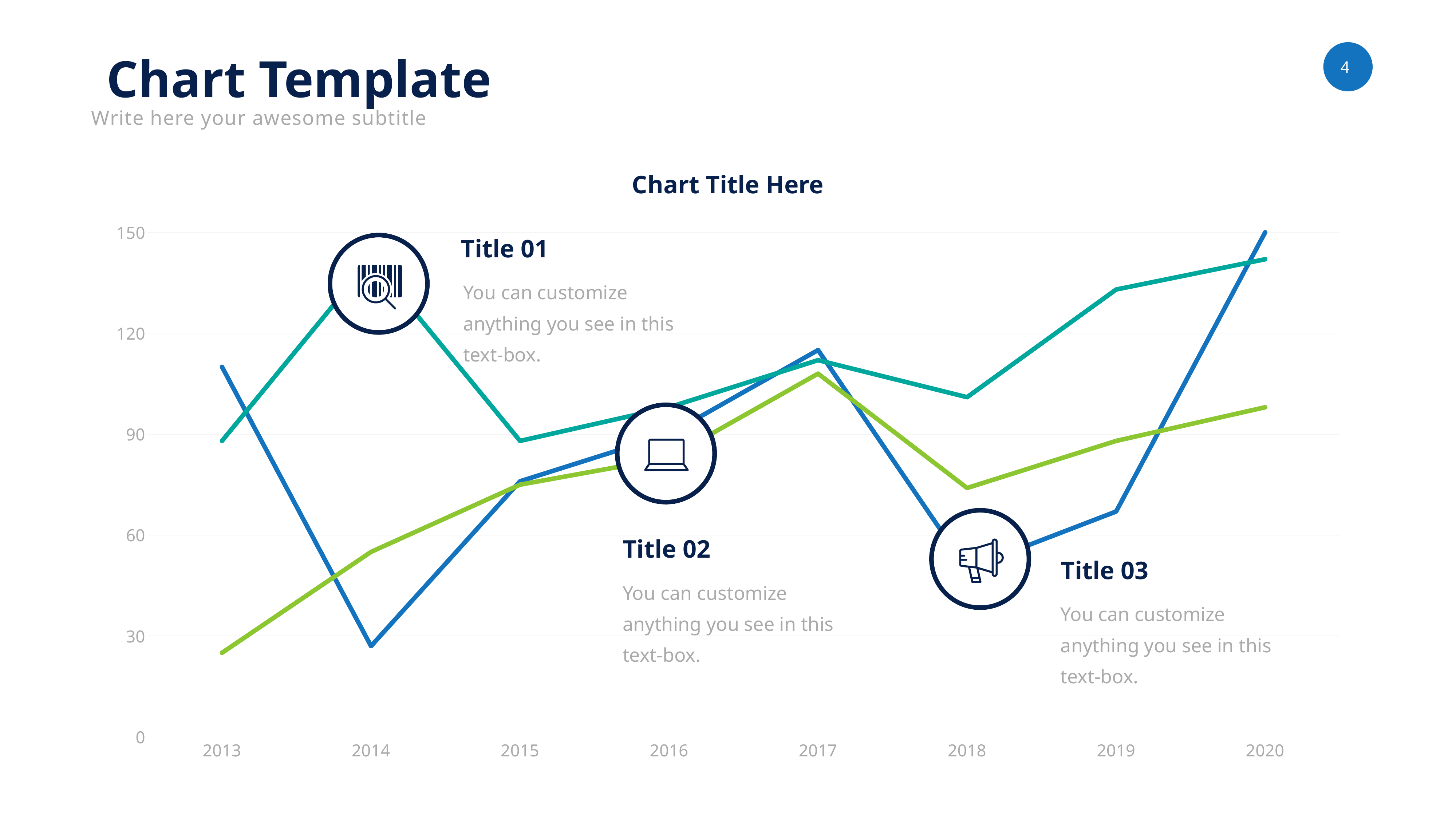
Is the value of the teal line in 2014 greater or less than 120? greater What is the title printed above the chart? Chart Title Here What kind of chart is shown on the slide? line chart In which year does the blue line reach its highest value? 2020 Does the green line rise or fall from 2013 to 2017? rise In 2014, which line has the higher value, the teal line or the blue line? teal line How many years are shown along the x axis of the chart? 8 In 2018, which line has the higher value, the blue line or the green line? green line How many lines are plotted on the chart? 3 Is the value of the blue line in 2020 greater or less than 120? greater Does the blue line rise or fall from 2013 to 2014? fall Is the value of the blue line in 2014 greater or less than 60? less